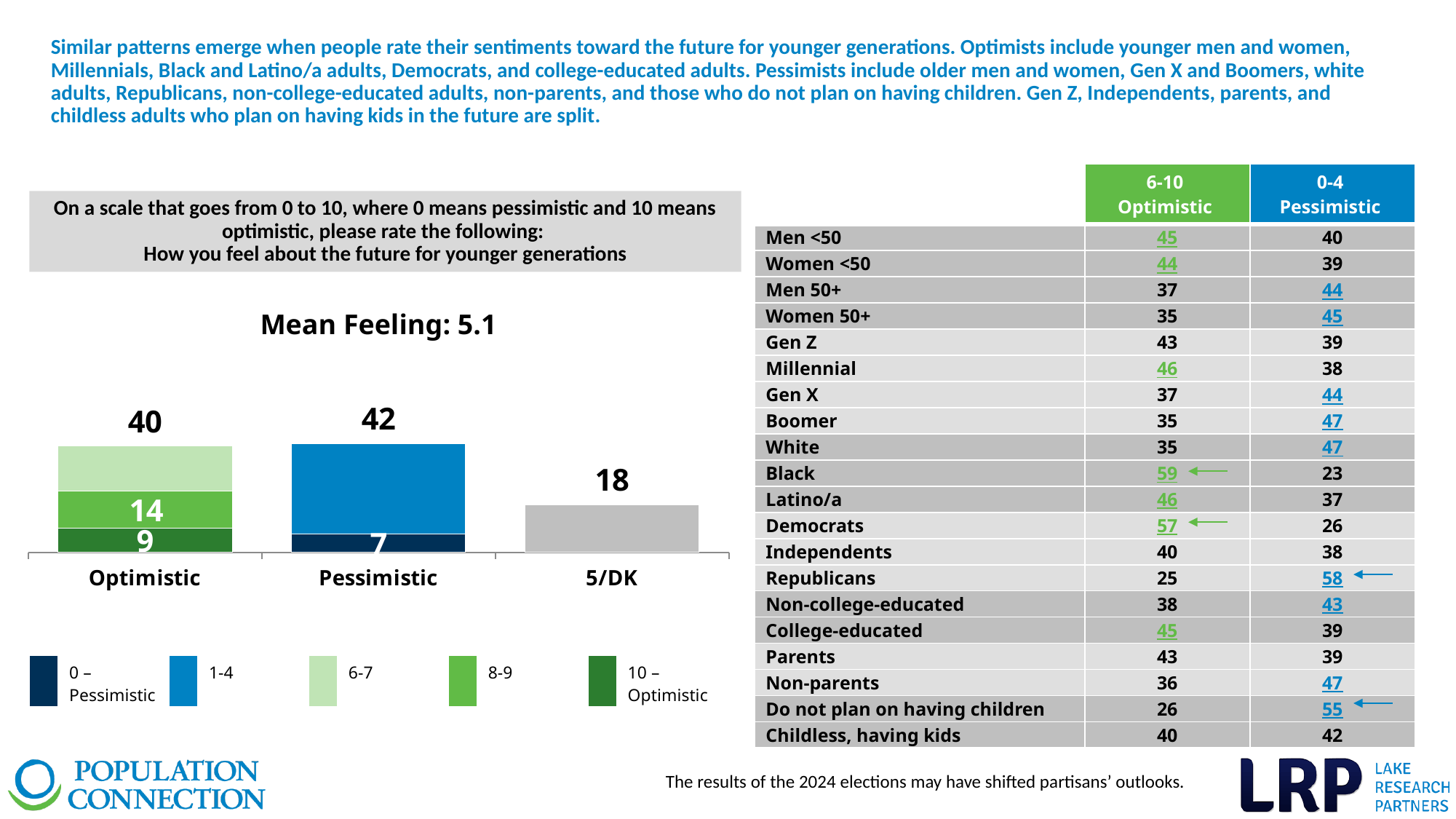
Within the Optimistic bar, what is the value of the 10 – Optimistic segment? 9 What is the difference between the Pessimistic total and the Optimistic total? 2 Within the Pessimistic bar, what is the value of the 0 – Pessimistic segment? 7 What is the total value of the Optimistic bar? 40 Within the Optimistic bar, what is the value of the 8-9 segment? 14 How many entries does the chart legend list? 5 What is the total value of the Pessimistic bar? 42 What mean feeling value is printed above the bar chart? 5.1 How many categories are shown on the x axis of the bar chart? 3 What is the value shown for the 5/DK bar? 18 Which category has the highest total in the bar chart? Pessimistic Which category has the lowest total in the bar chart? 5/DK